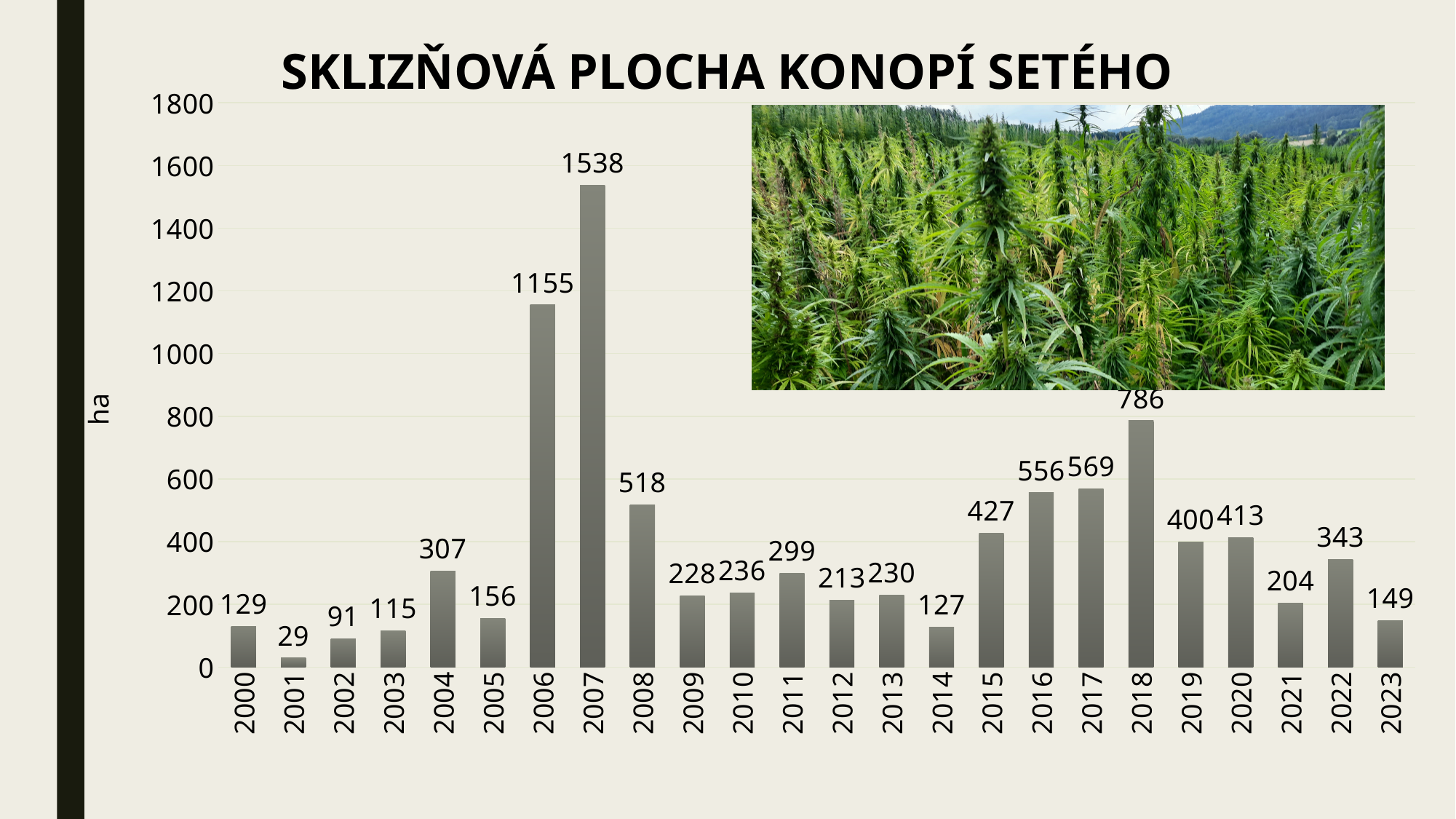
Which is larger, the value for 2016 or the value for 2015? 2016 Which year has the highest value? 2007 What is the difference between the values for 2007 and 2006? 383 What is the value for 2023? 149 Is the value for 2008 greater or less than 400? greater Do the values rise or fall from 2018 to 2021? fall What is the value for 2007? 1538 What kind of chart is this? bar chart What is the title of the chart? SKLIZŇOVÁ PLOCHA KONOPÍ SETÉHO How many years are shown on the x axis? 24 Which year has the lowest value? 2001 What is the value for 2018? 786